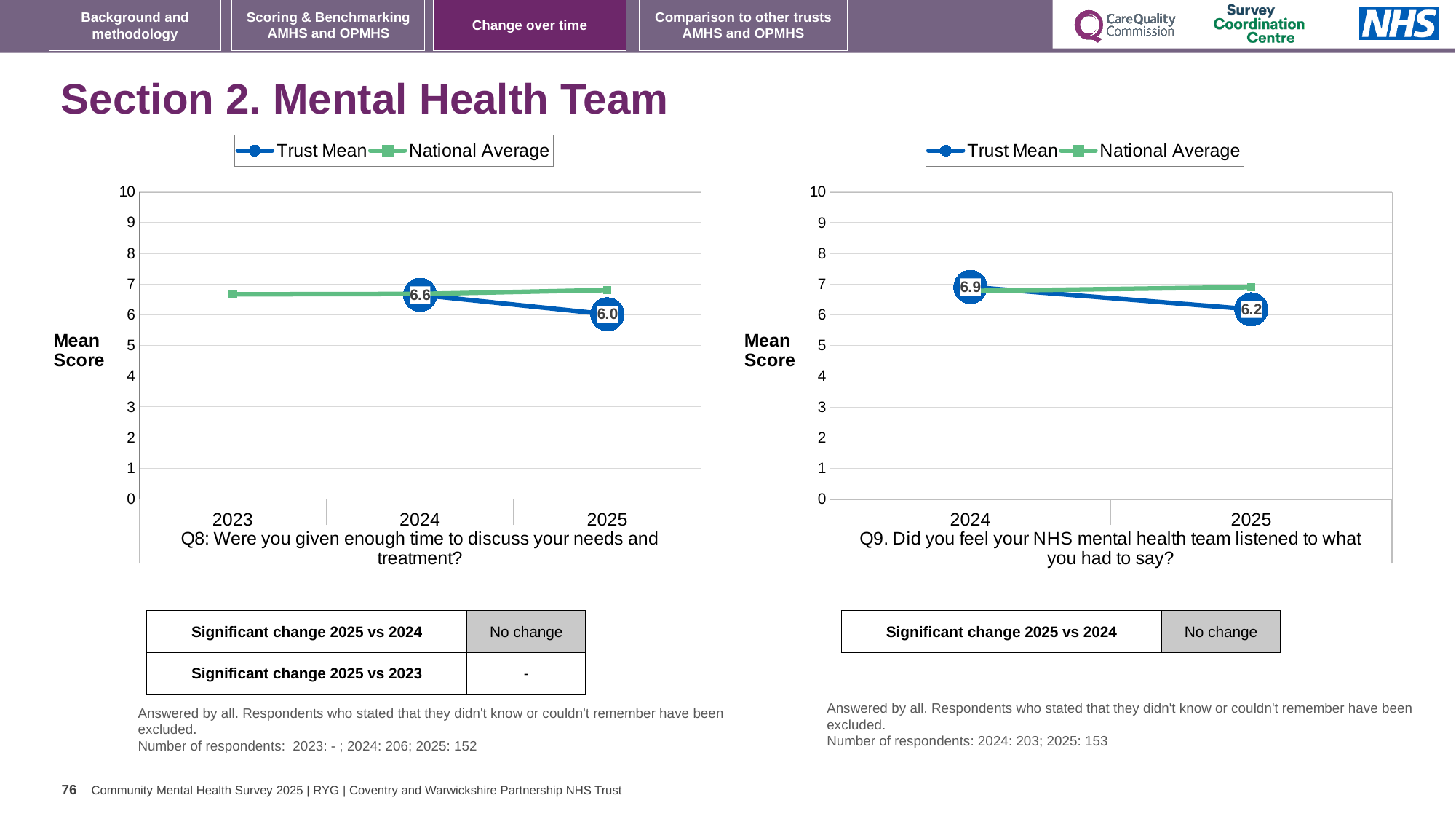
In the Q8 chart (left), is the National Average for 2025 greater or less than 6? greater In the Q8 chart (left), what is the Trust Mean for 2025? 6.0 In the Q9 chart (right), what is the difference between the Trust Mean in 2024 and 2025? 0.7 In the Q9 chart (right), what is the Trust Mean for 2025? 6.2 What kind of chart is the Q8 chart on the left? line chart In the Q9 chart (right), does the Trust Mean rise or fall from 2024 to 2025? fall In the Q8 chart (left), what is the Trust Mean for 2024? 6.6 How many series does the legend of the Q9 chart (right) list? 2 How many years are shown on the x axis of the Q8 chart (left)? 3 In the Q8 chart (left), by how much did the Trust Mean change from 2024 to 2025? 0.6 In the Q9 chart (right), which is larger in 2025, the Trust Mean or the National Average? National Average In the Q9 chart (right), what is the Trust Mean for 2024? 6.9